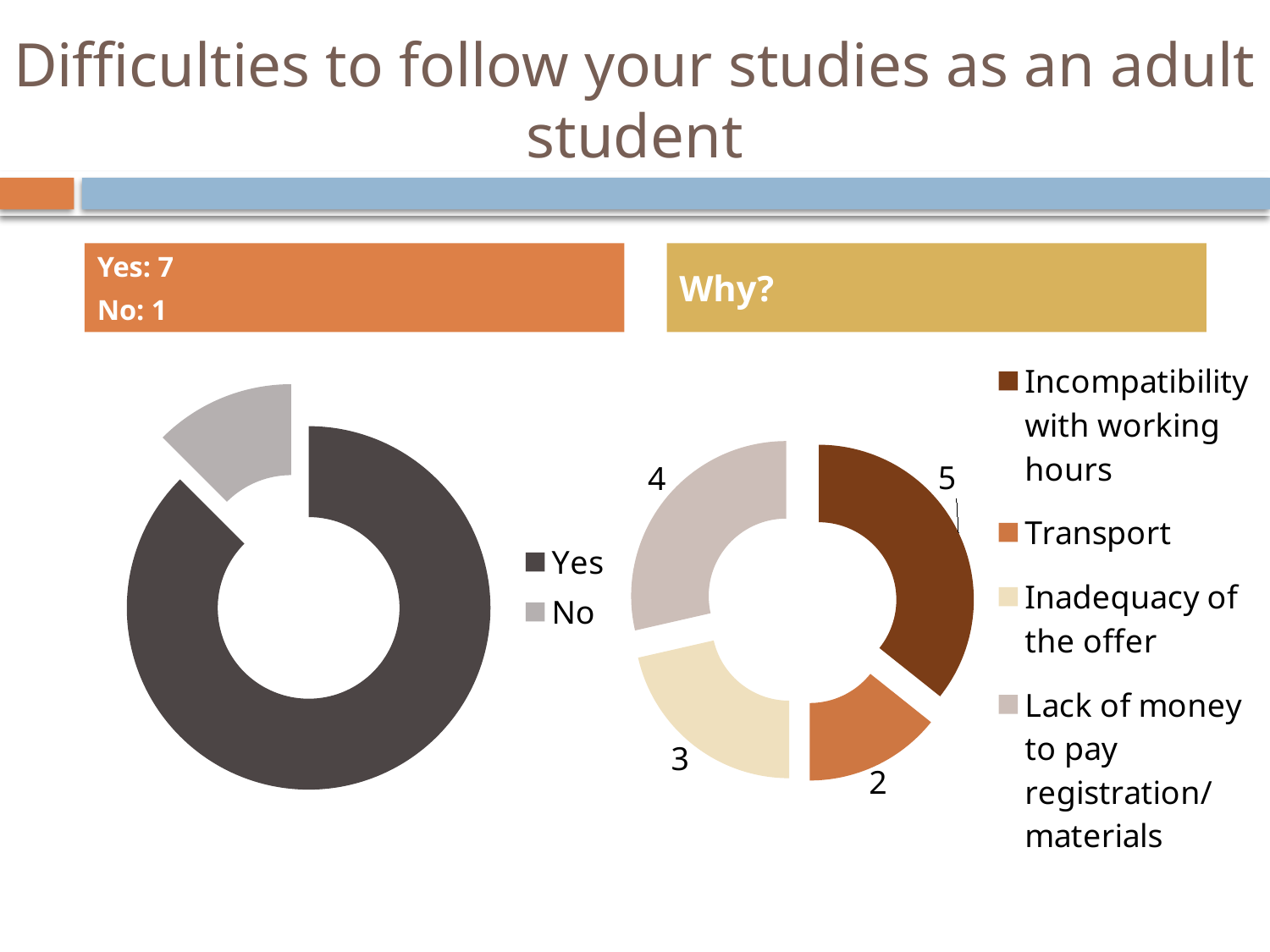
In the left-hand chart (Yes/No), which category is larger? Yes In the right-hand chart (Why?), what is the value for Inadequacy of the offer? 3 How many entries does the legend of the left-hand chart list? 2 In the right-hand chart (Why?), what is the value for Transport? 2 In the right-hand chart (Why?), which category has the highest value? Incompatibility with working hours In the right-hand chart (Why?), which is larger: Lack of money to pay registration/materials or Inadequacy of the offer? Lack of money to pay registration/materials How many categories does the right-hand chart (Why?) show? 4 In the right-hand chart (Why?), what is the value for Lack of money to pay registration/materials? 4 What kind of chart is the left-hand chart? doughnut chart In the right-hand chart (Why?), which category has the lowest value? Transport In the right-hand chart (Why?), what is the difference between Incompatibility with working hours and Transport? 3 In the right-hand chart (Why?), what is the value for Incompatibility with working hours? 5